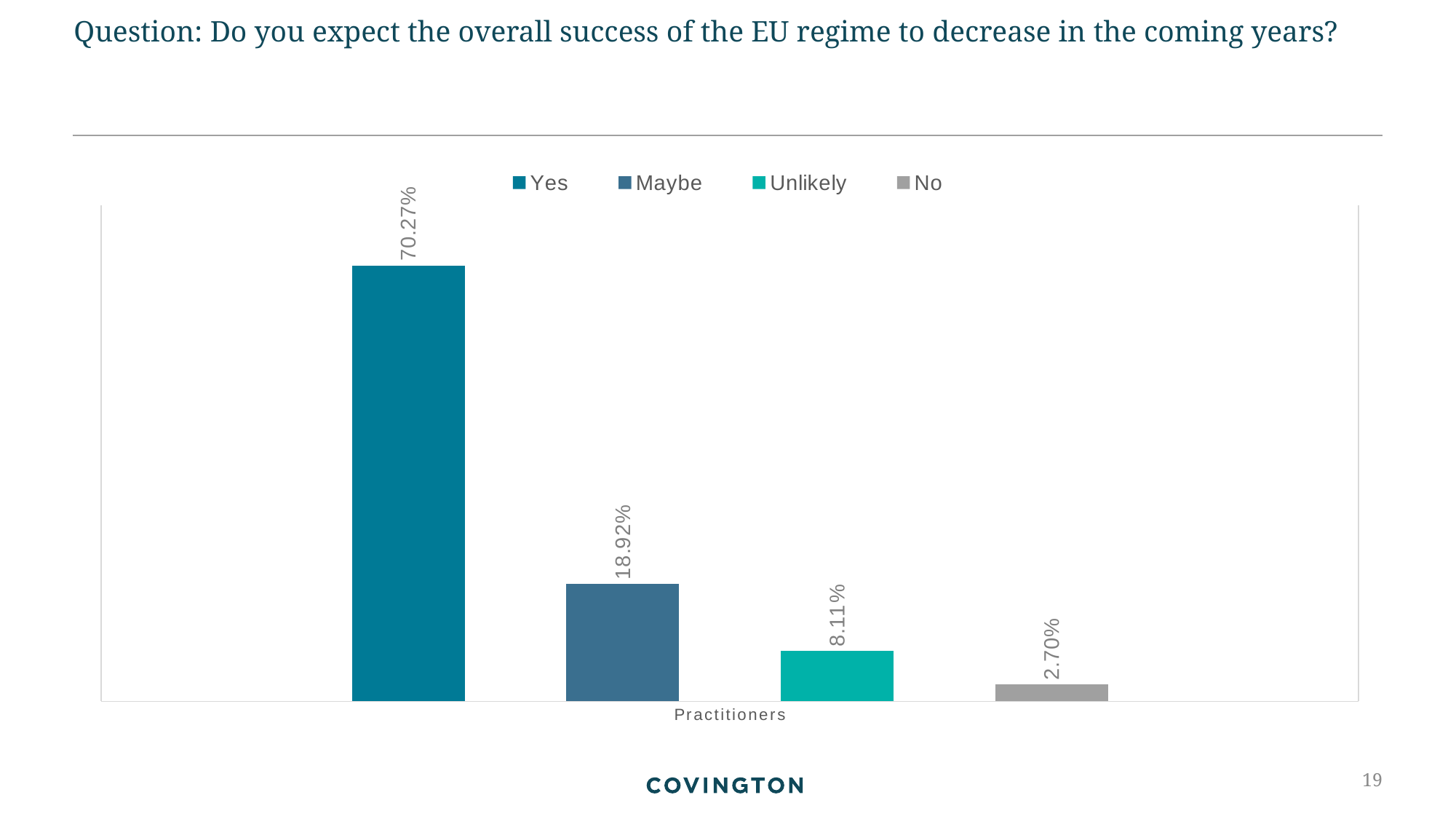
What percentage of Practitioners answered Maybe? 18.92% What kind of chart is shown on the slide? Bar chart Which response has the highest percentage among Practitioners? Yes What is the category label shown on the x axis? Practitioners What percentage of Practitioners answered Unlikely? 8.11% What percentage of Practitioners answered Yes? 70.27% What is the difference in percentage points between the Yes and Maybe responses? 51.35 How many series does the legend list? 4 What is the difference in percentage points between the Unlikely and No responses? 5.41 What percentage of Practitioners answered No? 2.70% Which is larger, the Maybe response or the Unlikely response? Maybe Which response has the lowest percentage among Practitioners? No